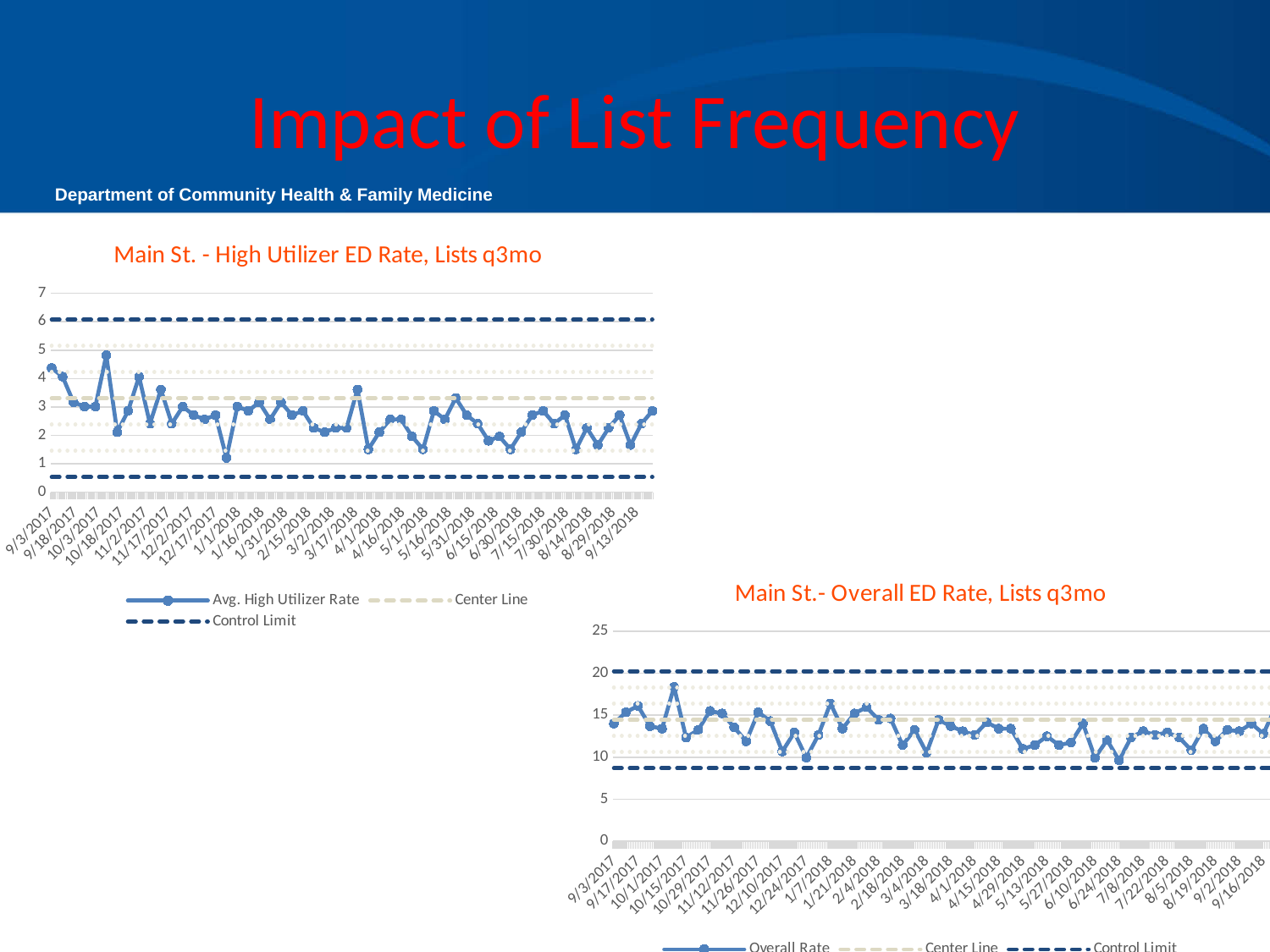
In "Main St. - High Utilizer ED Rate, Lists q3mo", is the upper Control Limit line greater or less than 5? greater What is the name of the solid plotted series in the legend of "Main St.- Overall ED Rate, Lists q3mo"? Overall Rate In "Main St.- Overall ED Rate, Lists q3mo", is the lower Control Limit line greater or less than 10? less In "Main St. - High Utilizer ED Rate, Lists q3mo", does the Avg. High Utilizer Rate generally rise or fall from the start to the end of the period? fall In "Main St. - High Utilizer ED Rate, Lists q3mo", is the Avg. High Utilizer Rate on 9/3/2017 greater or less than 3? greater What kind of chart is "Main St.- Overall ED Rate, Lists q3mo"? line chart What kind of chart is "Main St. - High Utilizer ED Rate, Lists q3mo"? line chart How many series does the legend of "Main St.- Overall ED Rate, Lists q3mo" list? 3 How many series does the legend of "Main St. - High Utilizer ED Rate, Lists q3mo" list? 3 What is the title of the chart in the upper left of the slide? Main St. - High Utilizer ED Rate, Lists q3mo